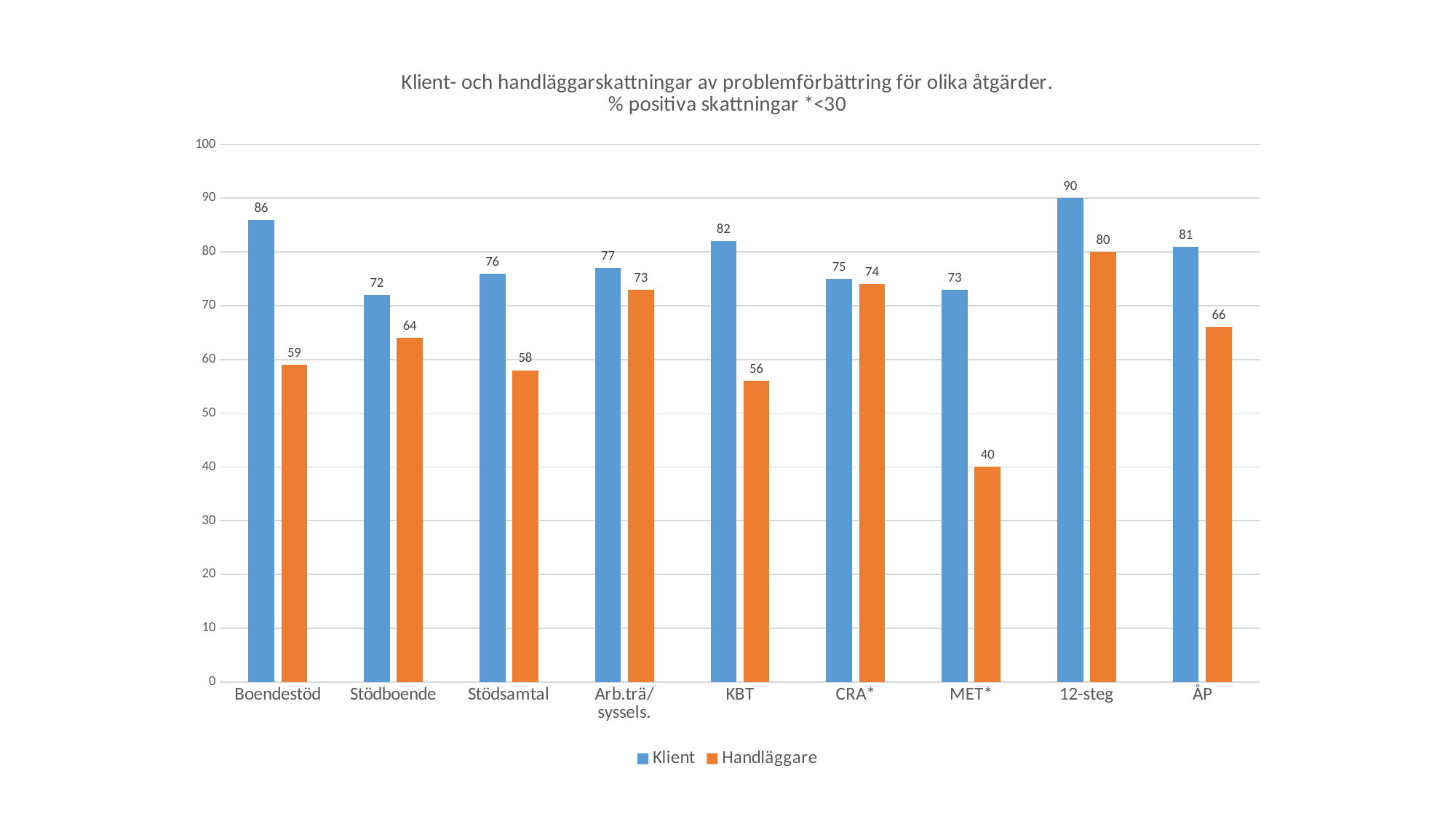
Which colour represents the Handläggare series? orange How many series does the legend list? 2 Which category has the lowest Handläggare value? MET* Is the Handläggare value for ÅP greater or less than 70? less Which category has the highest Klient value? 12-steg Which is larger for Stödboende, the Klient value or the Handläggare value? Klient What is the Handläggare value for Arb.trä/syssels.? 73 How many categories are shown on the x axis? 9 What is the difference between the Klient and Handläggare values for KBT? 26 What kind of chart is shown on the slide? bar chart What is the Handläggare value for MET*? 40 What is the Klient value for Boendestöd? 86